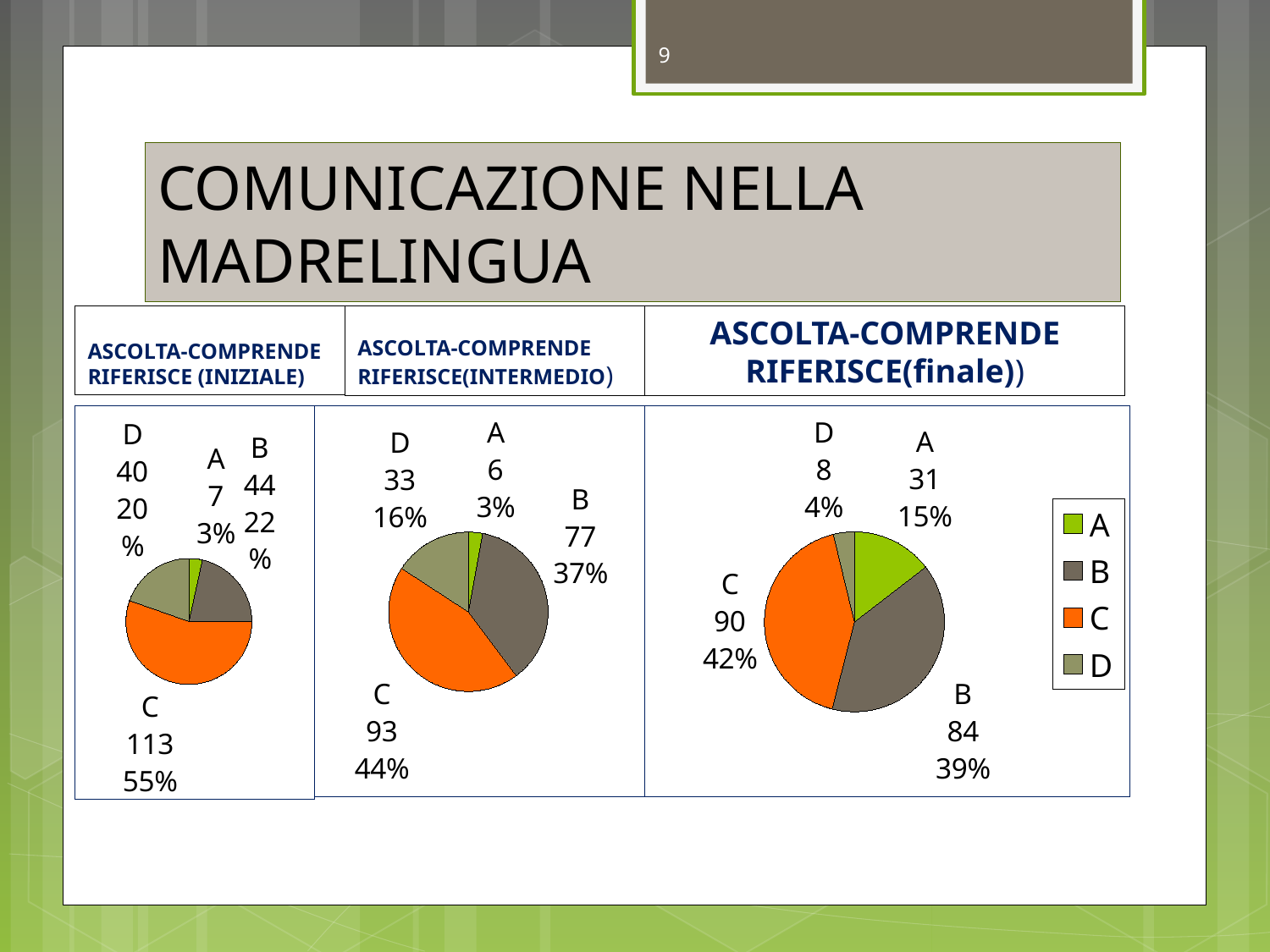
In the left pie chart (INIZIALE), which category has the largest slice? C In the middle pie chart (ASCOLTA-COMPRENDE RIFERISCE(INTERMEDIO)), what is the value for D? 33 How many categories does the legend on the right list? 4 In the right pie chart (finale), which is larger, the value for C or the value for B? C In the right pie chart (finale), which category has the smallest slice? D In the middle pie chart (INTERMEDIO), what is the difference between the values for C and B? 16 In the right pie chart (finale), what percentage share does slice B have? 39% What type of chart is used on this slide? Pie chart In the left pie chart (INIZIALE), what percentage share does slice B have? 22% In the right pie chart (ASCOLTA-COMPRENDE RIFERISCE(finale)), what is the value for A? 31 In the left pie chart (ASCOLTA-COMPRENDE RIFERISCE (INIZIALE)), what is the value for C? 113 In the middle pie chart (INTERMEDIO), what percentage share does slice C have? 44%